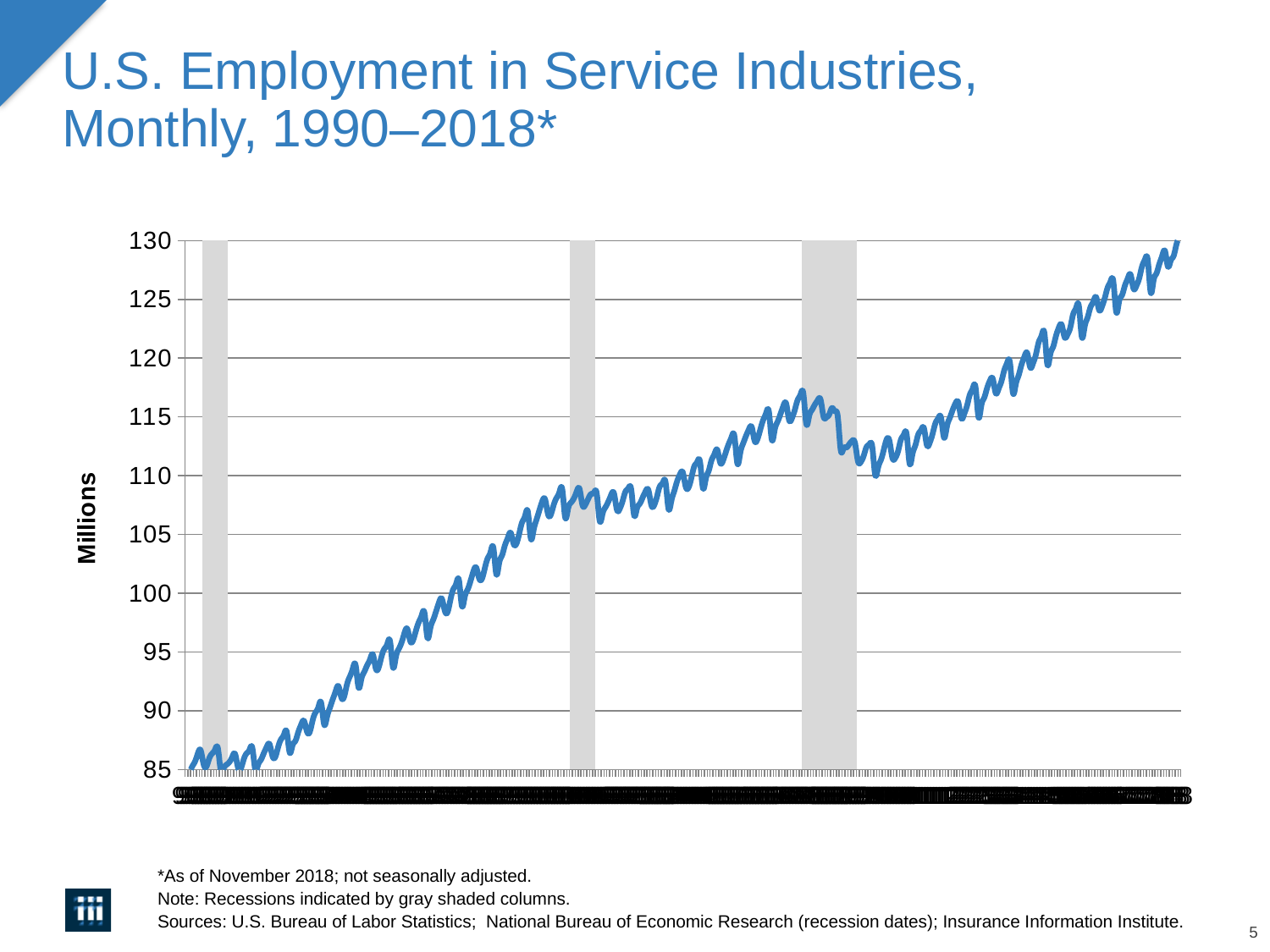
Is the value at the start of the series (1990) greater or less than 90? less What is the label on the vertical axis of the chart? Millions What kind of chart is shown on the slide? line chart Do the values in the chart generally rise or fall from left to right over 1990–2018? rise What is the highest tick value shown on the vertical axis? 130 How many gray shaded recession columns appear on the chart? 3 Is the lowest point of the series during the third (rightmost) gray shaded recession column greater or less than 115? less Is the value at the end of the series (late 2018) greater or less than 125? greater Is the value at the end of the series greater or less than the value at the start of the series? greater